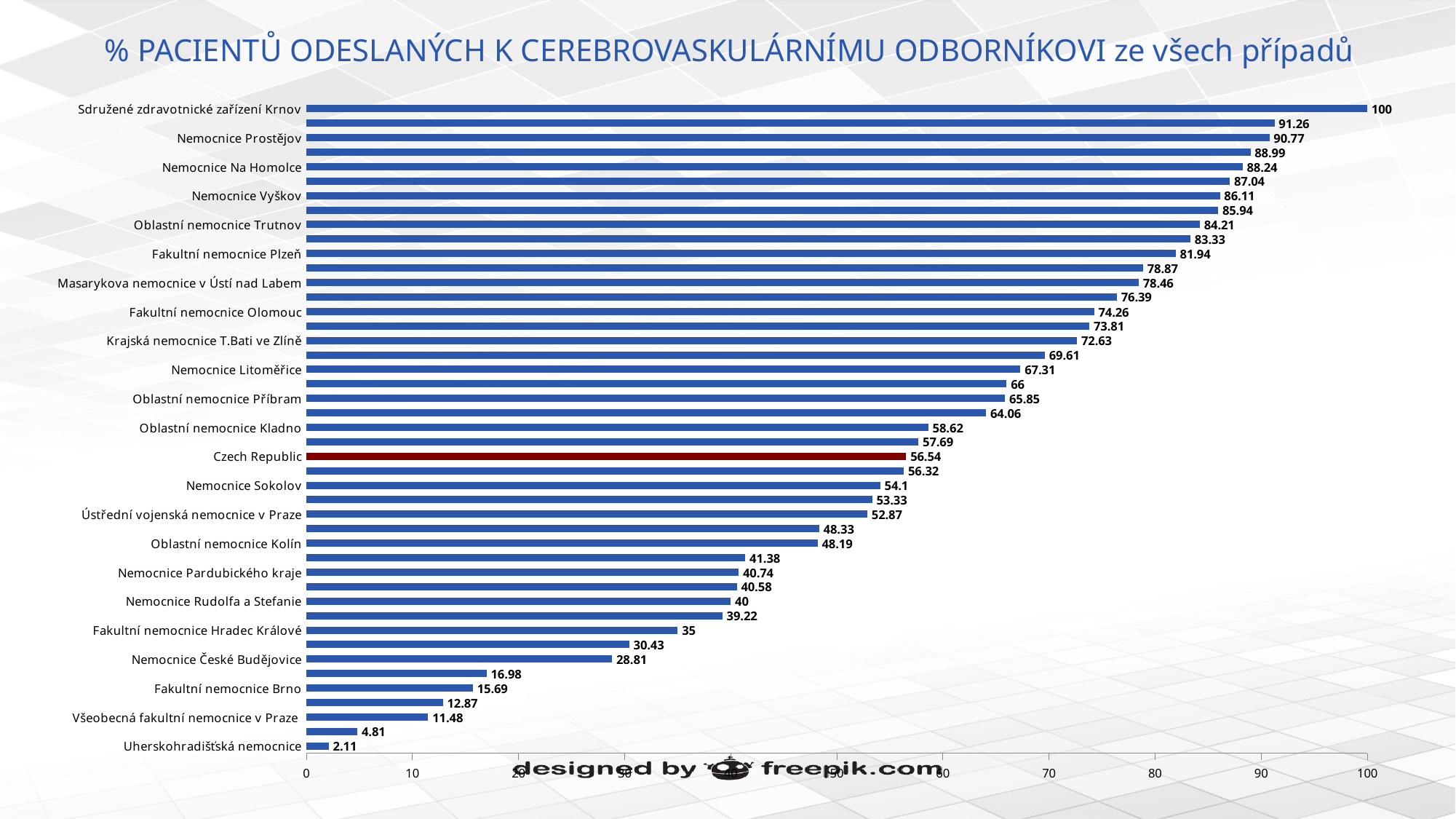
What is the value for Sdružené zdravotnické zařízení Krnov? 100 What is the difference between the values for Nemocnice Prostějov and Nemocnice Vyškov? 4.66 What is the value for Nemocnice Na Homolce? 88.24 What type of chart is shown on the slide? bar chart What is the value for Czech Republic? 56.54 What is the title of the chart? % PACIENTŮ ODESLANÝCH K CEREBROVASKULÁRNÍMU ODBORNÍKOVI ze všech případů Which category's bar is coloured red instead of blue? Czech Republic Which is larger, the value for Oblastní nemocnice Kladno or the value for Nemocnice Sokolov? Oblastní nemocnice Kladno Which labelled category has the lowest value? Uherskohradišťská nemocnice What is the value for Fakultní nemocnice Brno? 15.69 Is the value for Fakultní nemocnice Hradec Králové greater or less than 40? less Which labelled category has the highest value? Sdružené zdravotnické zařízení Krnov